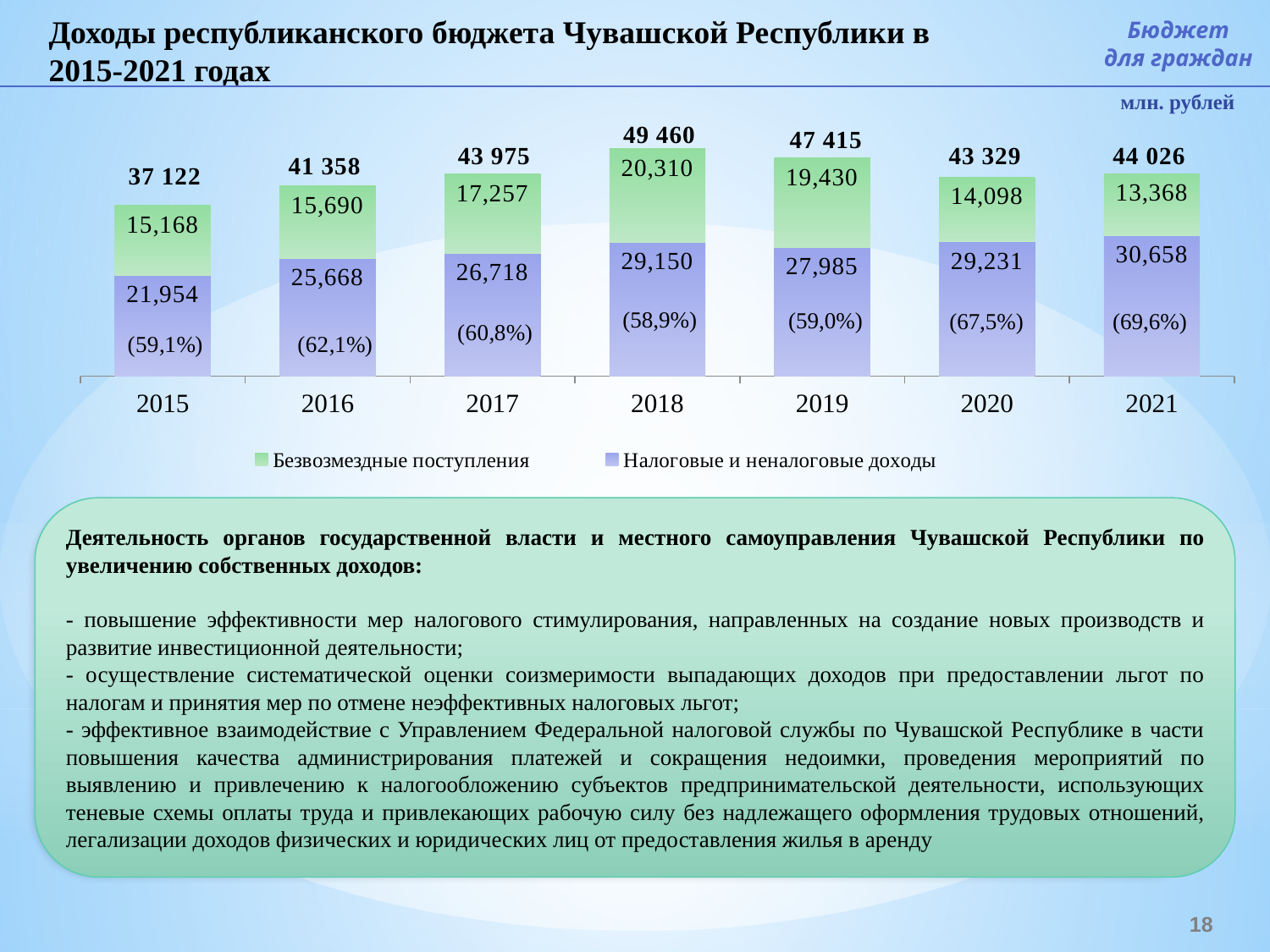
How many years are shown on the x axis? 7 Which year has the lowest total revenue? 2015 How many series does the legend list? 2 What kind of chart is shown on the slide? Stacked bar chart Which year has the larger value of Безвозмездные поступления, 2016 or 2017? 2017 What percentage share is shown for Налоговые и неналоговые доходы in 2020? 67,5% Which year has the highest total revenue? 2018 Do the total revenues rise or fall from 2015 to 2018? Rise What is the value of Налоговые и неналоговые доходы for 2018? 29,150 What is the value of Безвозмездные поступления for 2021? 13,368 What is the total of the stacked bar for 2019? 47 415 What is the difference between Налоговые и неналоговые доходы in 2021 and in 2020? 1,427